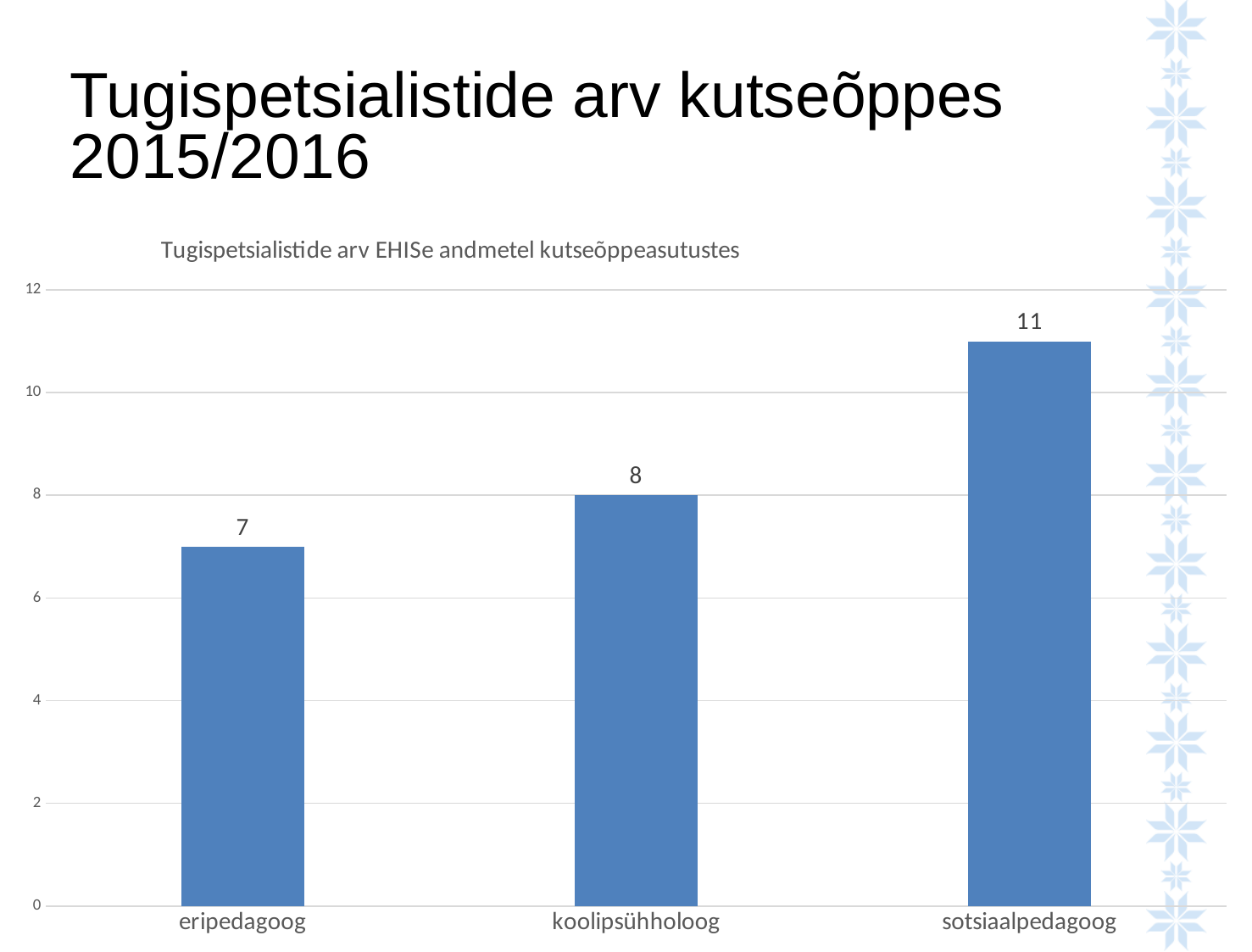
What is the difference between the values for koolipsühholoog and eripedagoog? 1 What is the title of the chart? Tugispetsialistide arv EHISe andmetel kutseõppeasutustes Which is larger, the value for koolipsühholoog or the value for sotsiaalpedagoog? sotsiaalpedagoog What is the value for koolipsühholoog? 8 Which category has the highest value? sotsiaalpedagoog How many categories are shown on the x axis? 3 What is the value for sotsiaalpedagoog? 11 What is the value for eripedagoog? 7 Is the value for sotsiaalpedagoog greater or less than 10? greater What is the difference between the values for sotsiaalpedagoog and eripedagoog? 4 Which category has the lowest value? eripedagoog What kind of chart is shown on the slide? bar chart